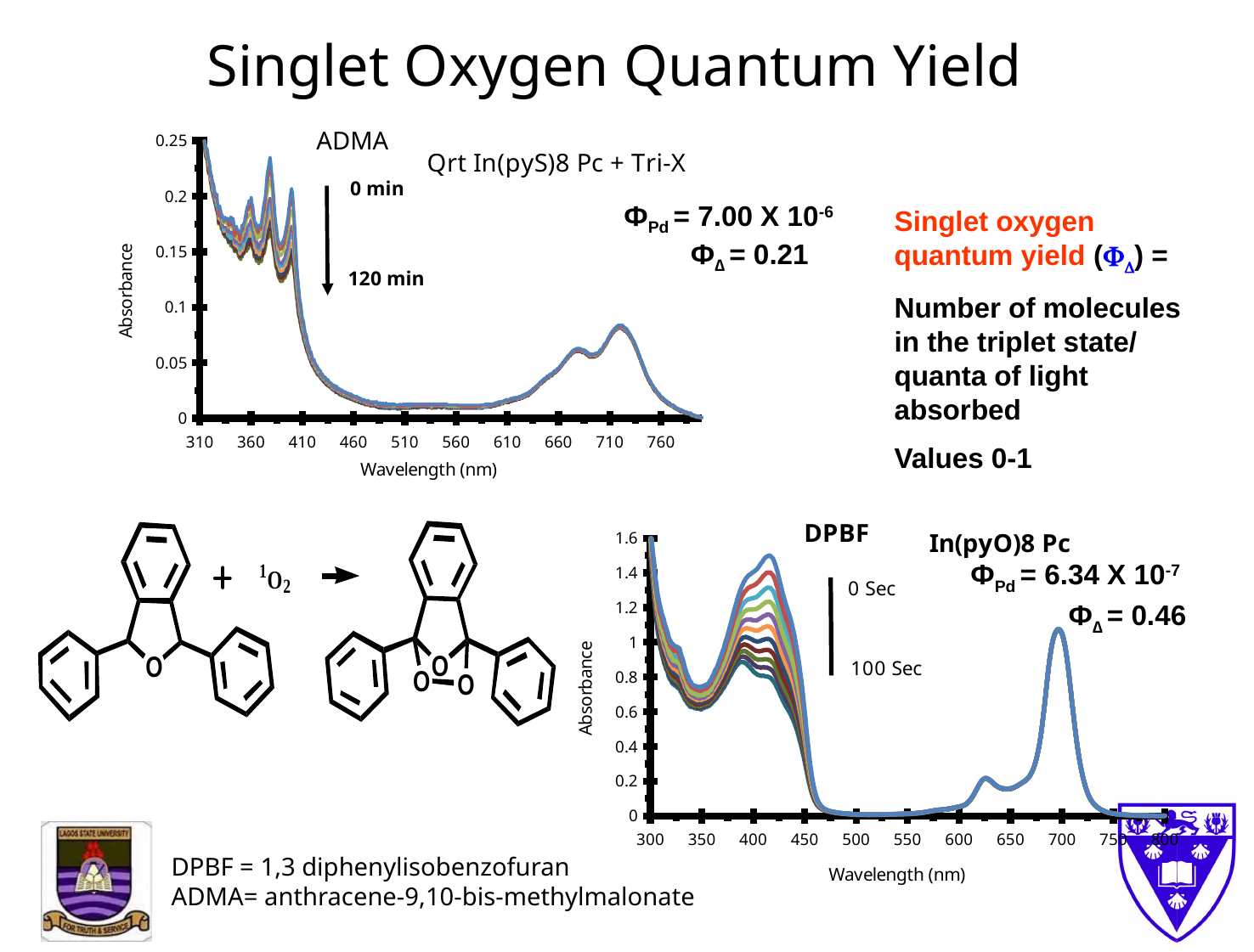
In the bottom DPBF chart, is the absorbance of the 0 Sec curve at its peak near 415 nm greater or less than 1.2? greater In the bottom DPBF chart, is the absorbance at the peak near 700 nm greater or less than 1.2? less In the top ADMA chart, is the absorbance at the peak near 715 nm greater or less than 0.05? greater In the top ADMA chart, which peak is higher: the one near 675 nm or the one near 715 nm? the one near 715 nm What is the x-axis label of the top ADMA chart? Wavelength (nm) What kind of chart is the top chart labelled ADMA? line chart In the top ADMA chart, does the absorbance in the 350-400 nm region rise or fall as time goes from 0 min to 120 min? fall In the bottom DPBF chart, does the absorbance near 415 nm rise or fall as time goes from 0 Sec to 100 Sec? fall What is the highest value shown on the y axis of the bottom DPBF chart? 1.6 In the bottom DPBF chart, which peak is higher: the one near 625 nm or the one near 700 nm? the one near 700 nm